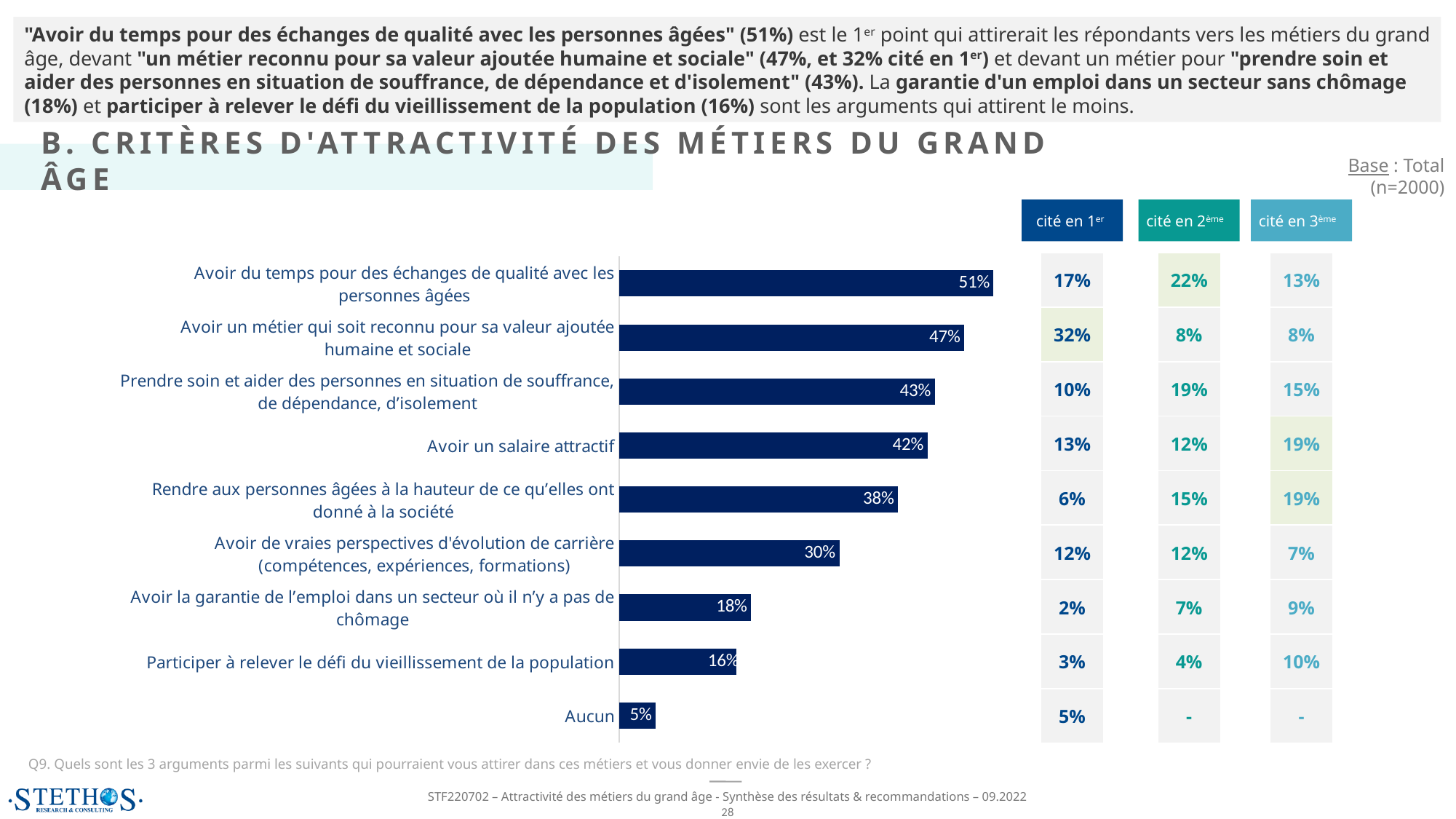
What is the value of the bar for "Avoir un salaire attractif"? 42% How many categories are shown in the bar chart? 9 What is the value of the bar for "Participer à relever le défi du vieillissement de la population"? 16% Which has a larger bar value: "Rendre aux personnes âgées à la hauteur de ce qu'elles ont donné à la société" or "Avoir de vraies perspectives d'évolution de carrière"? Rendre aux personnes âgées à la hauteur de ce qu'elles ont donné à la société What is the difference between the bar values for "Avoir la garantie de l'emploi dans un secteur où il n'y a pas de chômage" and "Aucun"? 13% Which category has the highest bar value? Avoir du temps pour des échanges de qualité avec les personnes âgées What is the difference between the bar values for "Avoir du temps pour des échanges de qualité avec les personnes âgées" and "Avoir un métier qui soit reconnu pour sa valeur ajoutée humaine et sociale"? 4% What is the title of the section shown above the chart? B. Critères d'attractivité des métiers du grand âge In the "cité en 1er" column, what is the value for "Avoir un métier qui soit reconnu pour sa valeur ajoutée humaine et sociale"? 32% What type of chart is shown on the slide? Bar chart In the "cité en 2ème" column, what is the value for "Avoir du temps pour des échanges de qualité avec les personnes âgées"? 22% Which category has the lowest bar value? Aucun